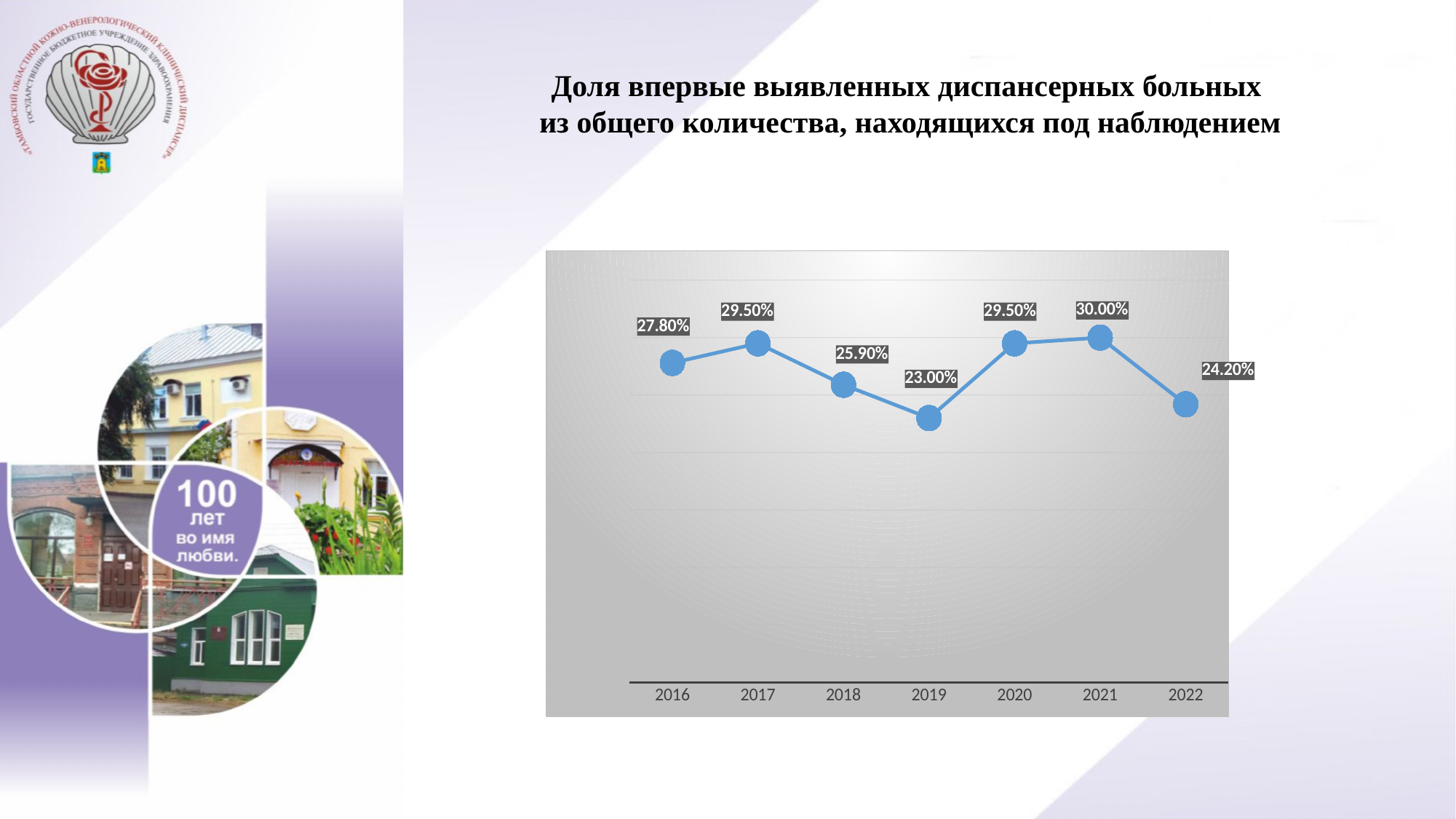
How many years are plotted on the chart? 7 Does the value rise or fall from 2019 to 2020? rise Which year has the highest value? 2021 What type of chart is shown on the slide? line chart What is the value for 2022? 24.20% Does the value rise or fall from 2021 to 2022? fall What is the value for 2019? 23.00% What is the difference between the values for 2017 and 2018? 3.60% What is the difference between the values for 2021 and 2019? 7.00% Which is larger, the value for 2018 or the value for 2022? 2018 What is the value for 2016? 27.80% Which year has the lowest value? 2019